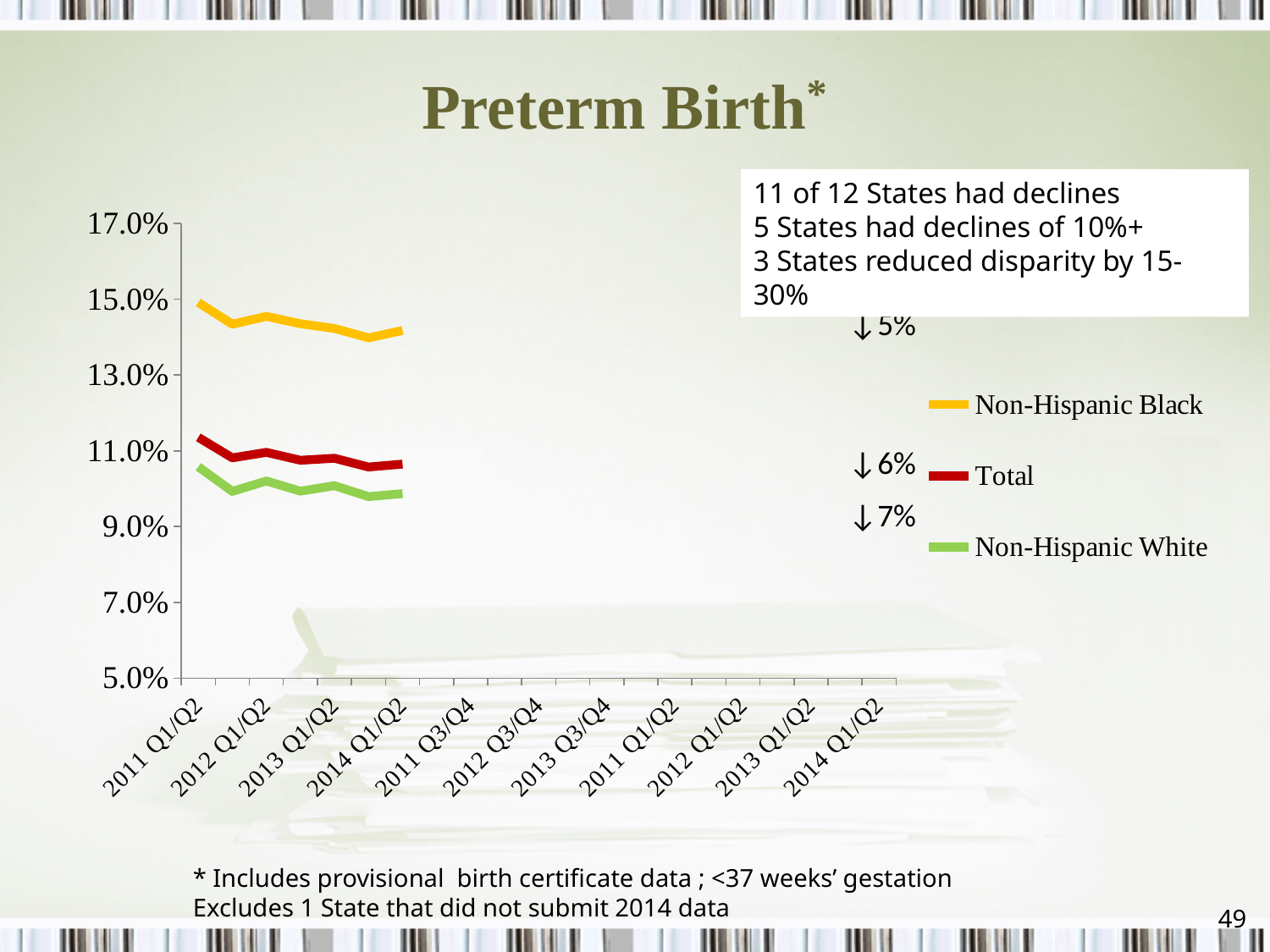
Is the value for Total at 2011 Q1/Q2 greater or less than 9.0%? greater Is the value for Non-Hispanic Black at 2014 Q1/Q2 greater or less than 15.0%? less What is the title of the chart? Preterm Birth* How many series does the legend list? 3 What colour is the line for Total? red Do the values for Non-Hispanic Black generally rise or fall from 2011 Q1/Q2 to 2014 Q1/Q2? fall Which series has the lowest values throughout the chart? Non-Hispanic White Is the value for Non-Hispanic Black at 2011 Q1/Q2 greater or less than 13.0%? greater Which series has the highest values throughout the chart? Non-Hispanic Black What kind of chart is shown on the slide? line chart At 2011 Q1/Q2, which is larger: the value for Non-Hispanic Black or the value for Non-Hispanic White? Non-Hispanic Black